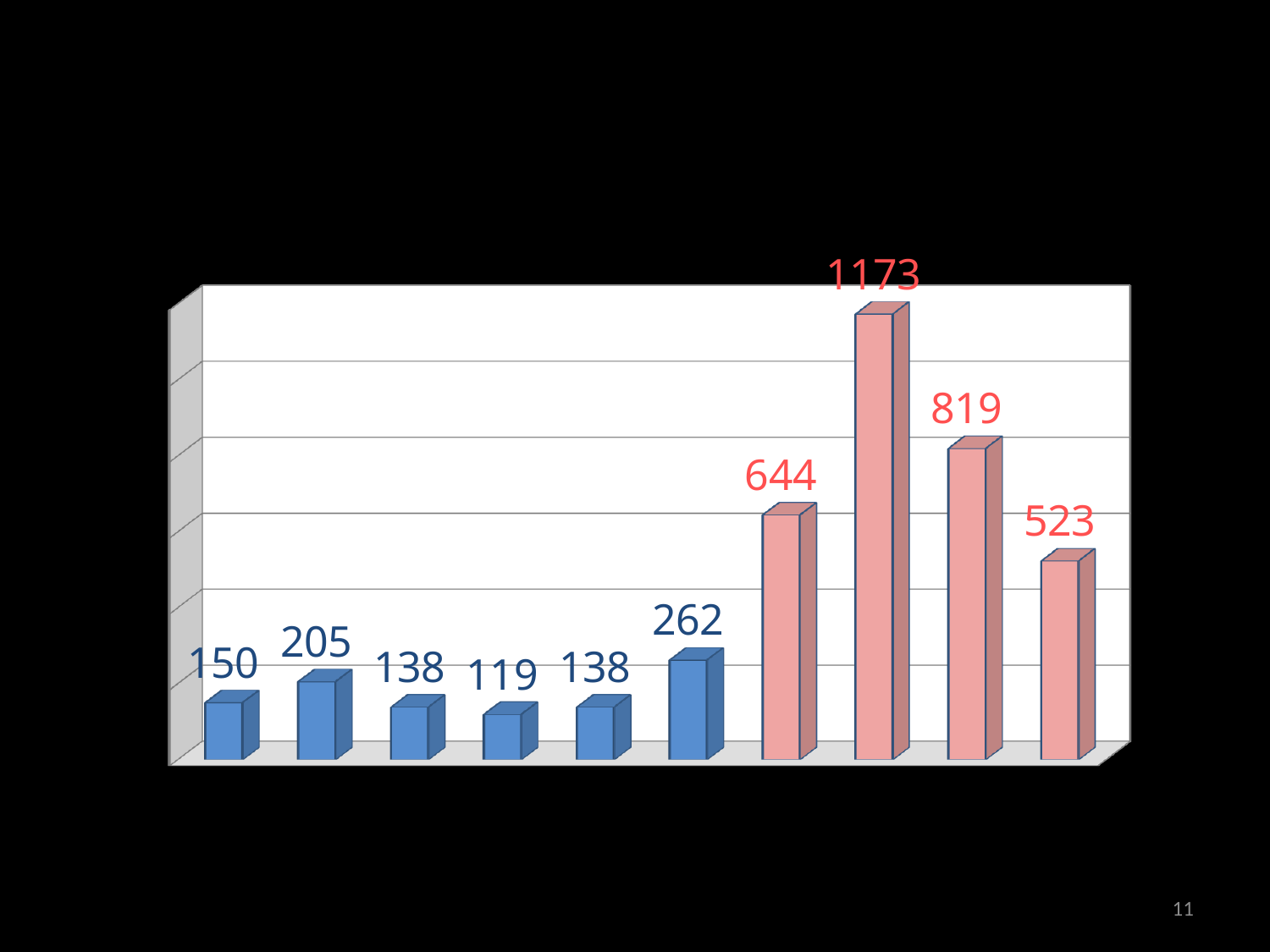
What is the value of the tallest bar in the chart? 1173 What kind of chart is shown on the slide? bar chart What is the value of the sixth bar from the left, the tallest blue bar? 262 Do the values of the four pink bars rise or fall from the second pink bar to the last pink bar? fall What is the value of the shortest bar in the chart? 119 What is the value shown on the first (leftmost) bar? 150 How many bars are plotted in the chart? 10 What is the difference between the tallest bar (1173) and the bar labelled 819? 354 How many bars in the chart are coloured pink/red rather than blue? 4 Which is larger, the second bar from the left (205) or the first bar (150)? the second bar (205) What is the difference between the bar labelled 644 and the bar labelled 262? 382 What is the value shown on the last (rightmost) bar? 523